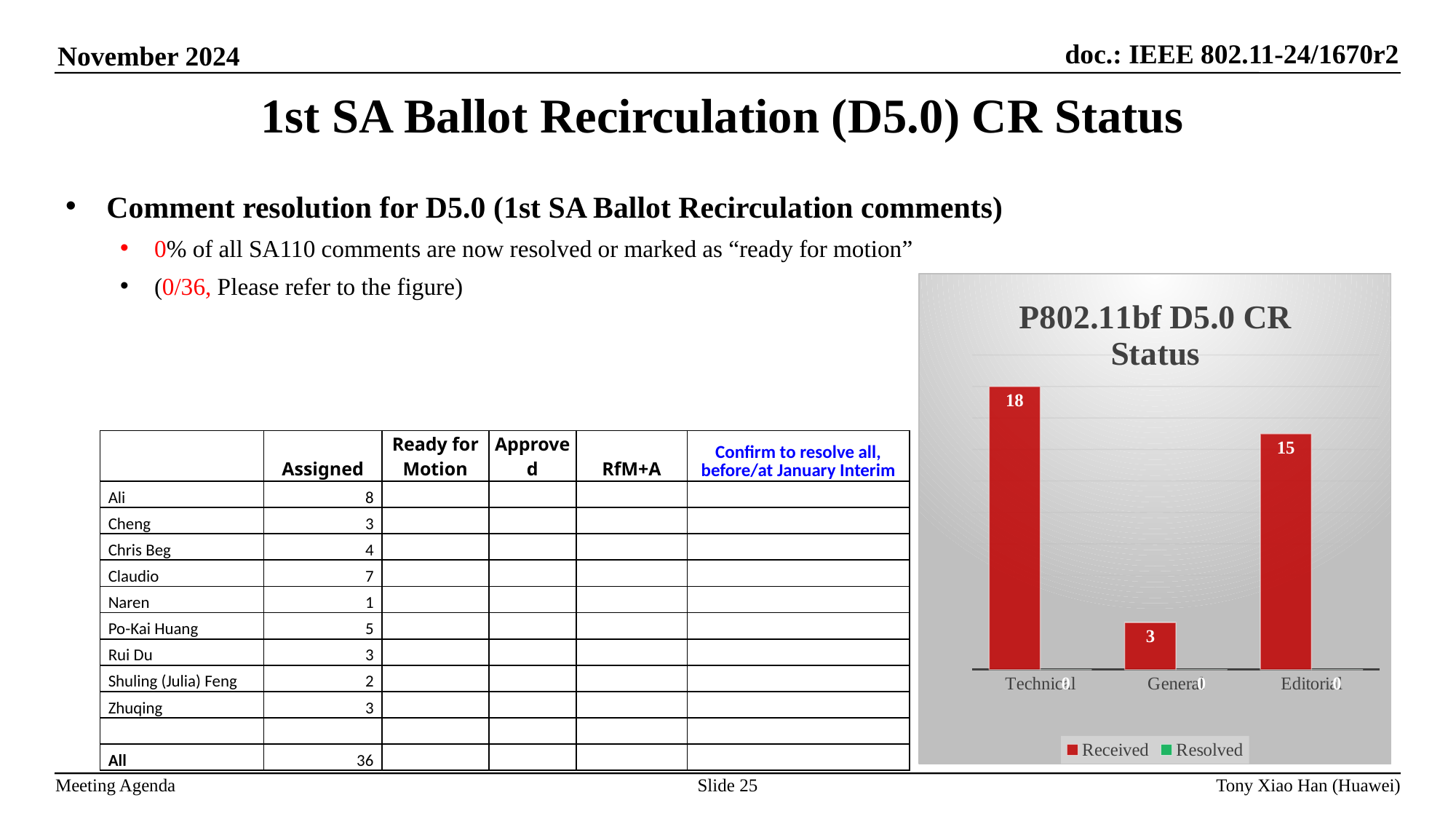
What type of chart is shown on the slide? bar chart What is the Received value for General? 3 What is the title of the chart? P802.11bf D5.0 CR Status What is the Received value for Technical? 18 What is the Received value for Editorial? 15 Which category has the lowest Received value? General How many series does the chart legend list? 2 Which has a larger Received value, General or Editorial? Editorial Which series are listed in the chart legend? Received, Resolved How many categories are shown on the x axis of the chart? 3 Which category has the highest Received value? Technical What is the difference between the Received values for Technical and Editorial? 3